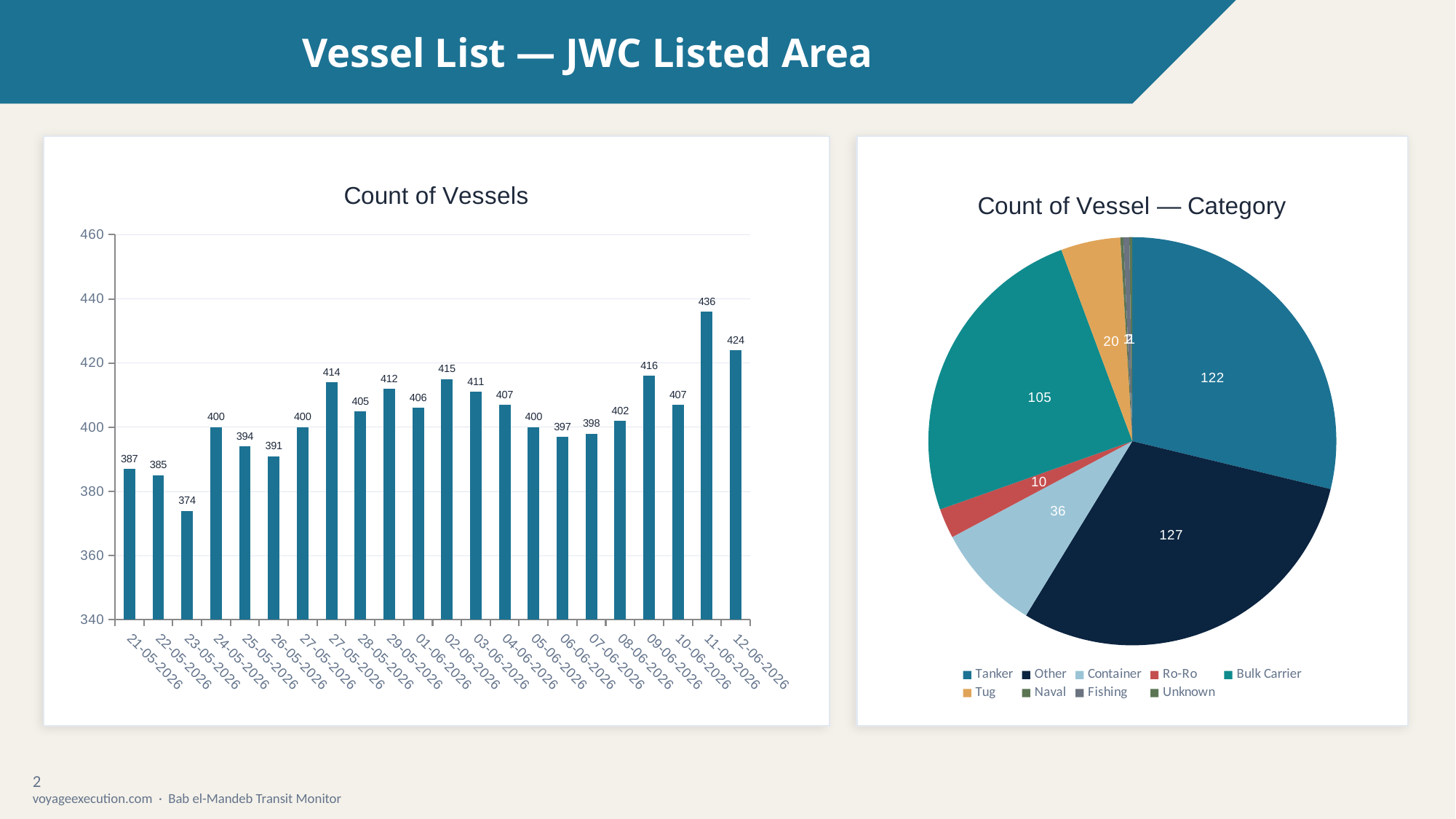
What kind of chart is the "Count of Vessels" chart on the left? bar chart In the "Count of Vessel — Category" pie chart, which is larger, Tanker or Other? Other In the "Count of Vessel — Category" pie chart, what is the value for Bulk Carrier? 105 In the "Count of Vessels" chart, what is the value for 12-06-2026? 424 In the "Count of Vessels" chart, what is the value for 21-05-2026? 387 In the "Count of Vessels" chart, what is the difference between the highest value (436) and the lowest value (374)? 62 How many categories does the legend of the "Count of Vessel — Category" pie chart list? 9 What kind of chart is the "Count of Vessel — Category" chart on the right? pie chart In the "Count of Vessels" chart, which date has the lowest count? 23-05-2026 In the "Count of Vessel — Category" pie chart, what is the difference between Tanker and Container? 86 In the "Count of Vessels" chart, which date has the highest count? 11-06-2026 In the "Count of Vessel — Category" pie chart, what is the value for Other? 127